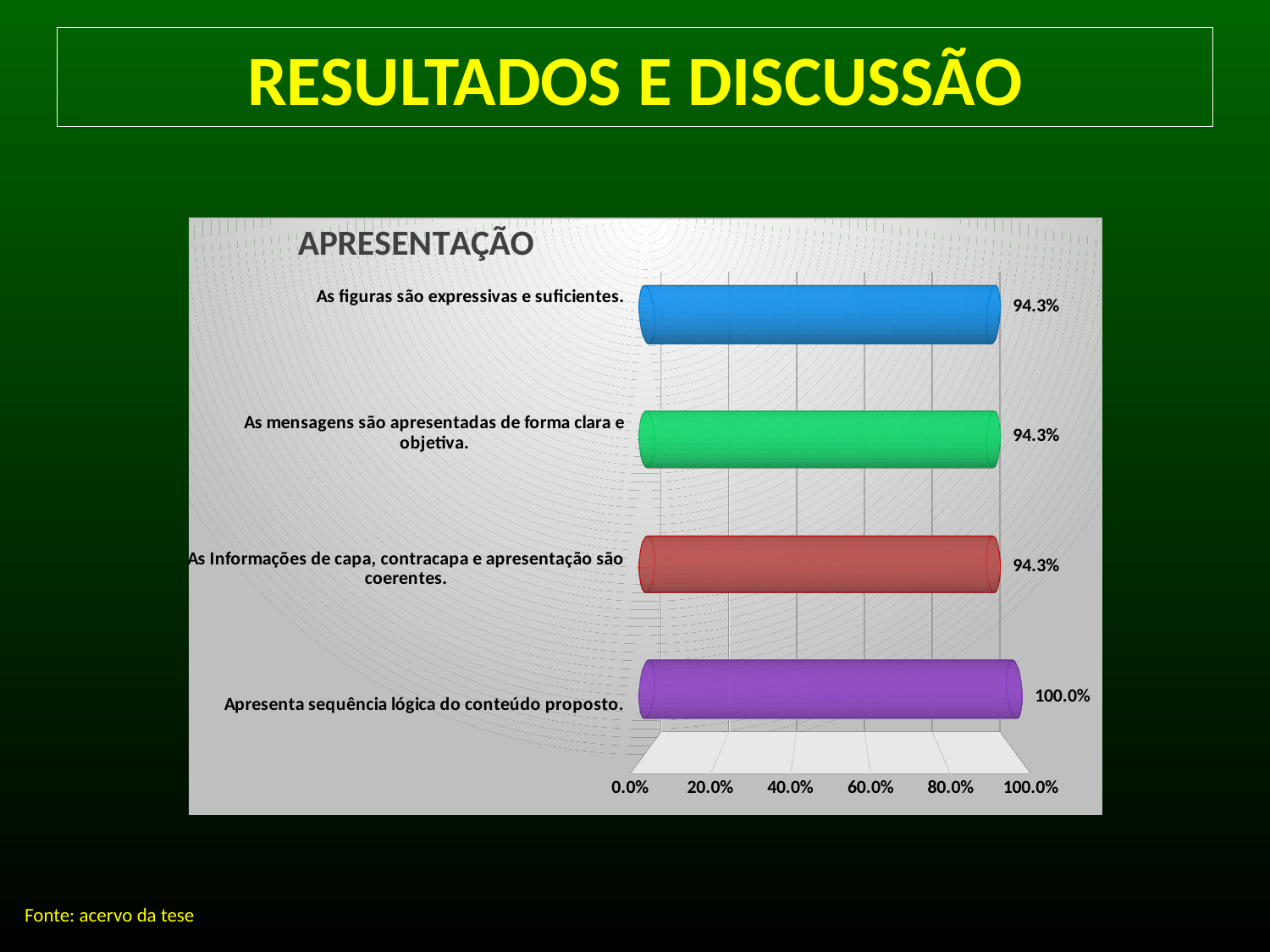
Is the value for "As mensagens são apresentadas de forma clara e objetiva." greater or less than 80.0%? greater What is the difference between the value for "Apresenta sequência lógica do conteúdo proposto." and the value for "As figuras são expressivas e suficientes."? 5.7% What is the value for "As mensagens são apresentadas de forma clara e objetiva."? 94.3% What kind of chart is shown on the slide? bar chart What is the value for "As Informações de capa, contracapa e apresentação são coerentes."? 94.3% What is the value for "Apresenta sequência lógica do conteúdo proposto."? 100.0% What is the value for "As figuras são expressivas e suficientes."? 94.3% Which category has the highest value? Apresenta sequência lógica do conteúdo proposto. What colour is the bar for "Apresenta sequência lógica do conteúdo proposto."? purple Which is larger: the value for "Apresenta sequência lógica do conteúdo proposto." or the value for "As Informações de capa, contracapa e apresentação são coerentes."? Apresenta sequência lógica do conteúdo proposto. How many categories are shown in the chart? 4 What is the title of the chart? APRESENTAÇÃO